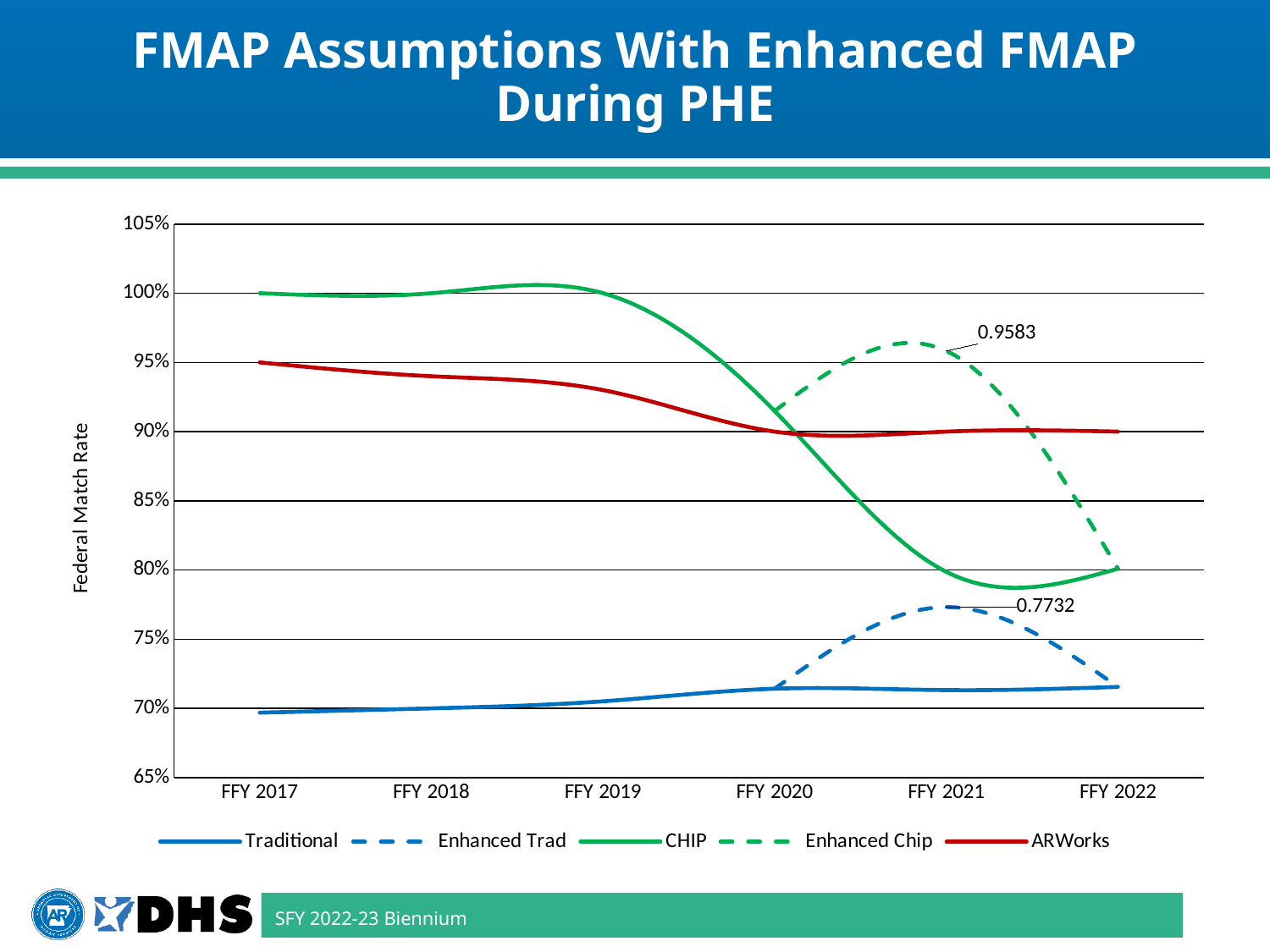
Does the CHIP line rise or fall from FFY 2019 to FFY 2021? fall Which series has the lowest value at FFY 2017? Traditional What is the title of the y axis? Federal Match Rate What is the labeled value for Enhanced Chip at FFY 2021? 0.9583 How many fiscal years are shown on the x axis? 6 Is the value for ARWorks at FFY 2022 greater or less than 85%? greater Which series has the highest value at FFY 2017? CHIP Is the value for Traditional at FFY 2017 greater or less than 75%? less What is the labeled value for Enhanced Trad at FFY 2021? 0.7732 How many series does the legend list? 5 What kind of chart is shown on the slide? line chart Is the value for CHIP at FFY 2017 greater or less than 95%? greater